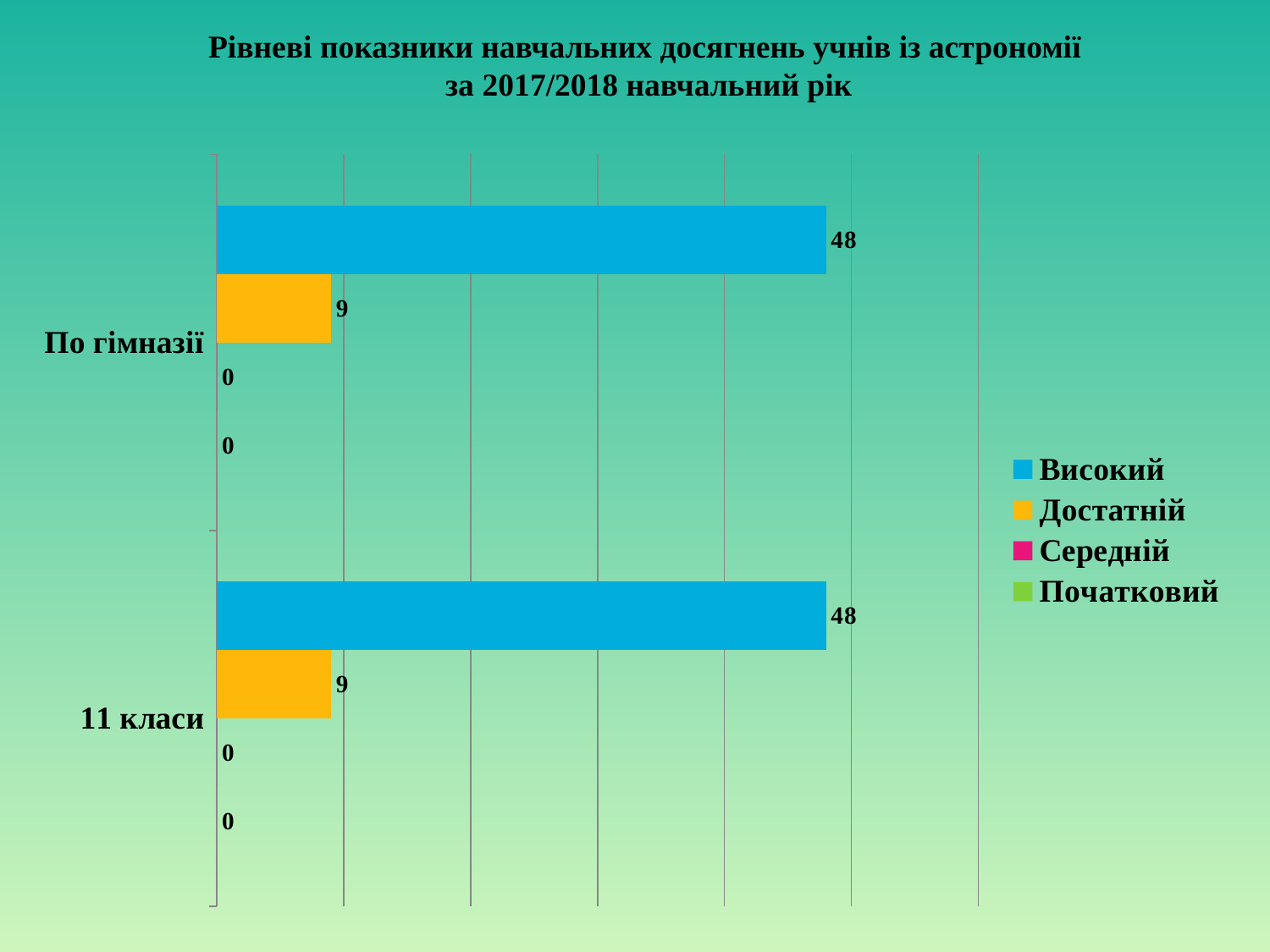
How many categories are shown on the vertical axis? 2 What is the difference between the Високий and Достатній values for 11 класи? 39 Which series has the highest value in the По гімназії category? Високий What is the total of the four series values for 11 класи? 57 What kind of chart is shown on the slide? Bar chart Which colour represents the Достатній series in the legend? Orange What is the value for Високий in the 11 класи category? 48 What is the value for Достатній in the По гімназії category? 9 How many series does the legend list? 4 What is the value for Початковий in the По гімназії category? 0 What is the value for Середній in the 11 класи category? 0 Which is larger for По гімназії: the Високий value or the Достатній value? Високий